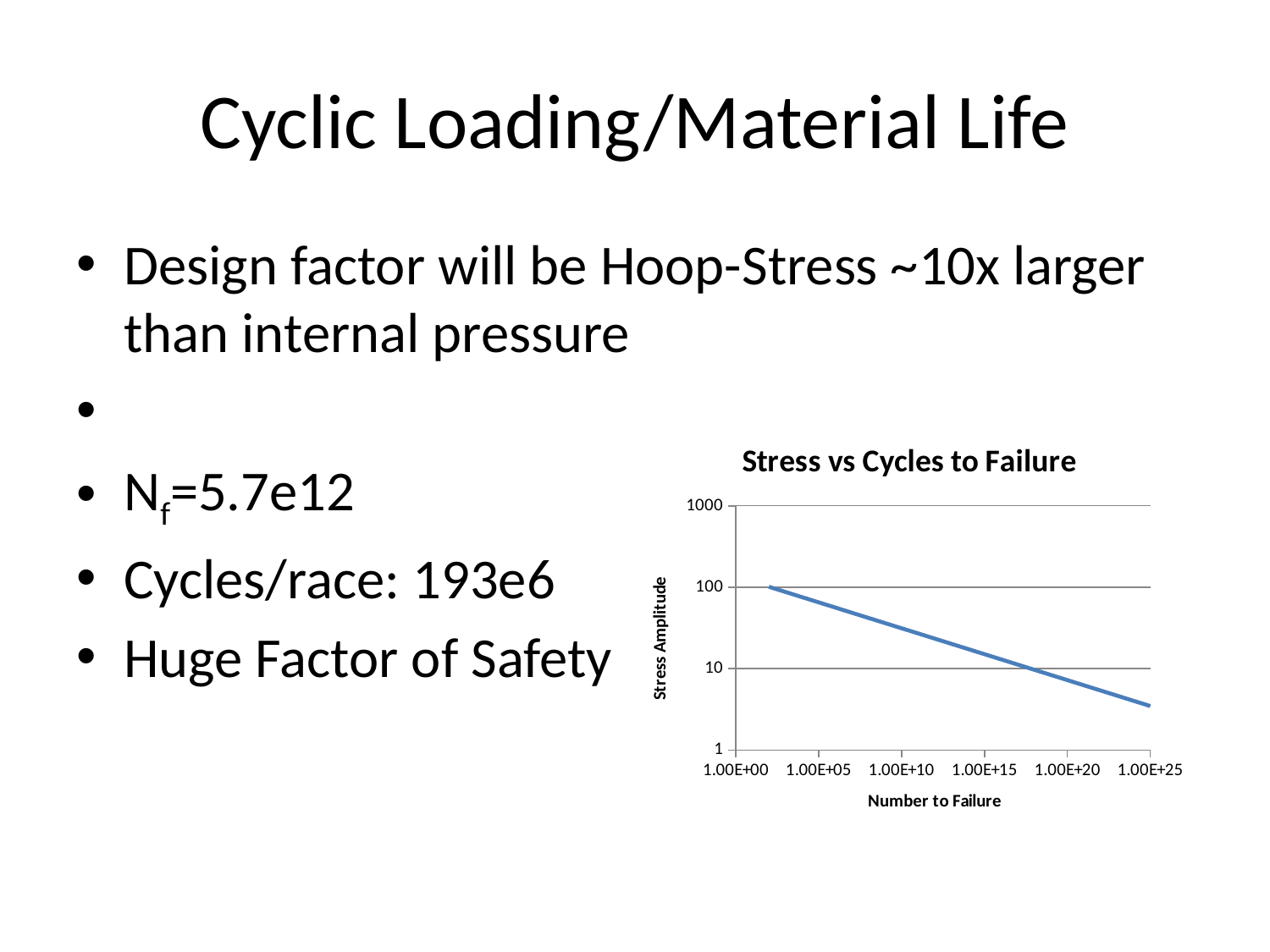
What kind of chart is shown on the slide? line chart Is the stress amplitude at a number to failure of 1.00E+10 greater or less than 100? less How many tick labels are shown on the x axis of the chart? 6 Which end of the line has the higher stress amplitude, the left end or the right end? left end What is the highest value labelled on the y axis of the chart? 1000 Does the stress amplitude rise or fall as the number to failure increases along the x axis? fall Is the stress amplitude at a number to failure of 1.00E+20 greater or less than 10? less Is the stress amplitude at a number to failure of 1.00E+05 greater or less than 100? less What is the label of the x axis of the chart? Number to Failure What is the title of the chart? Stress vs Cycles to Failure